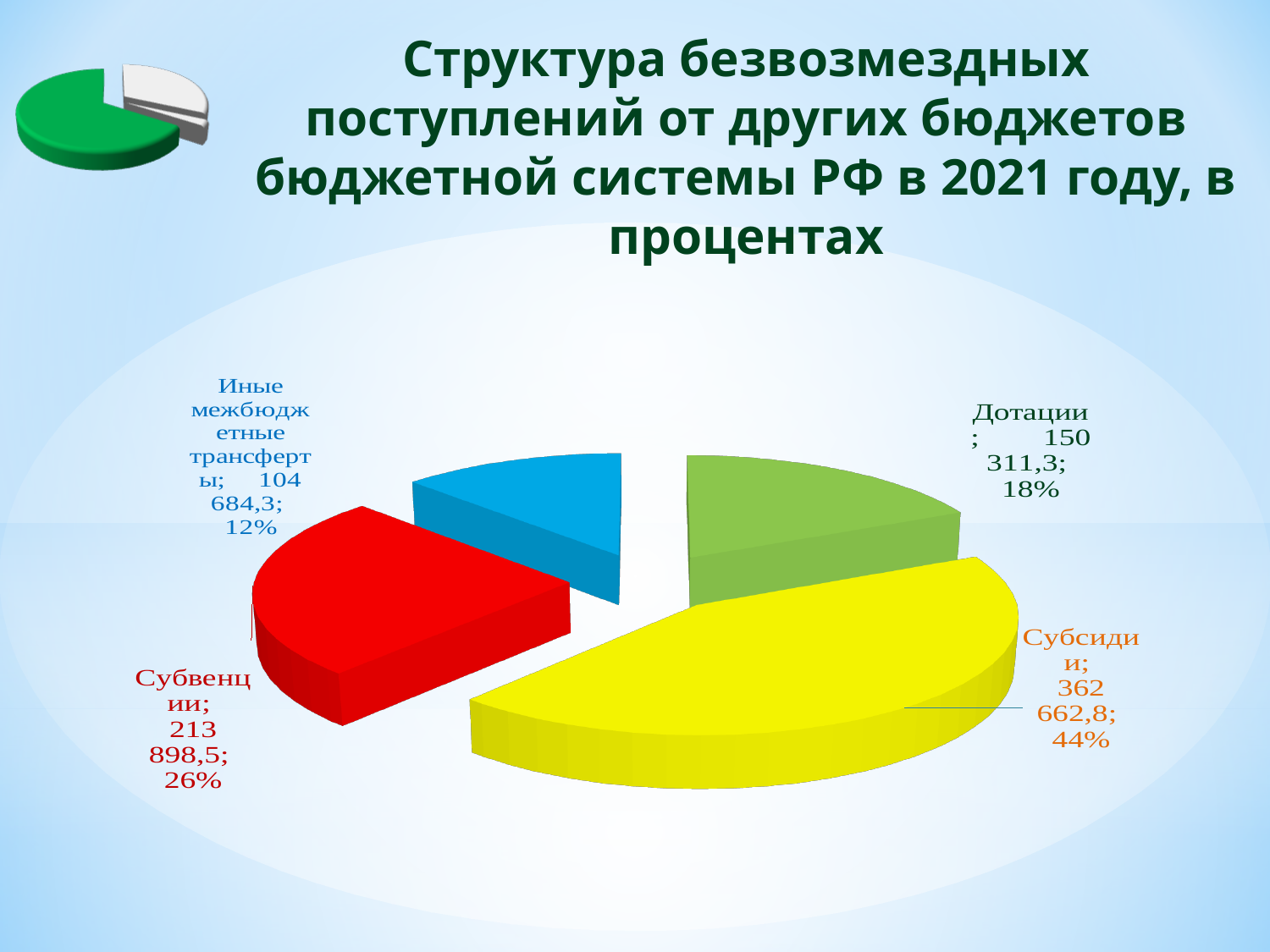
What value is shown for Дотации? 150 311,3 Which is larger, the share for Субвенции or the share for Дотации? Субвенции What percentage share does the Субсидии slice have? 44% What percentage share does the Субвенции slice have? 26% What value is shown for Субвенции? 213 898,5 What percentage share does the Иные межбюджетные трансферты slice have? 12% How many slices does the pie chart have? 4 Which category has the largest share of the pie? Субсидии Which category has the smallest share of the pie? Иные межбюджетные трансферты What is the difference in percentage points between the Субсидии share and the Субвенции share? 18 What type of chart is shown on the slide? Pie chart